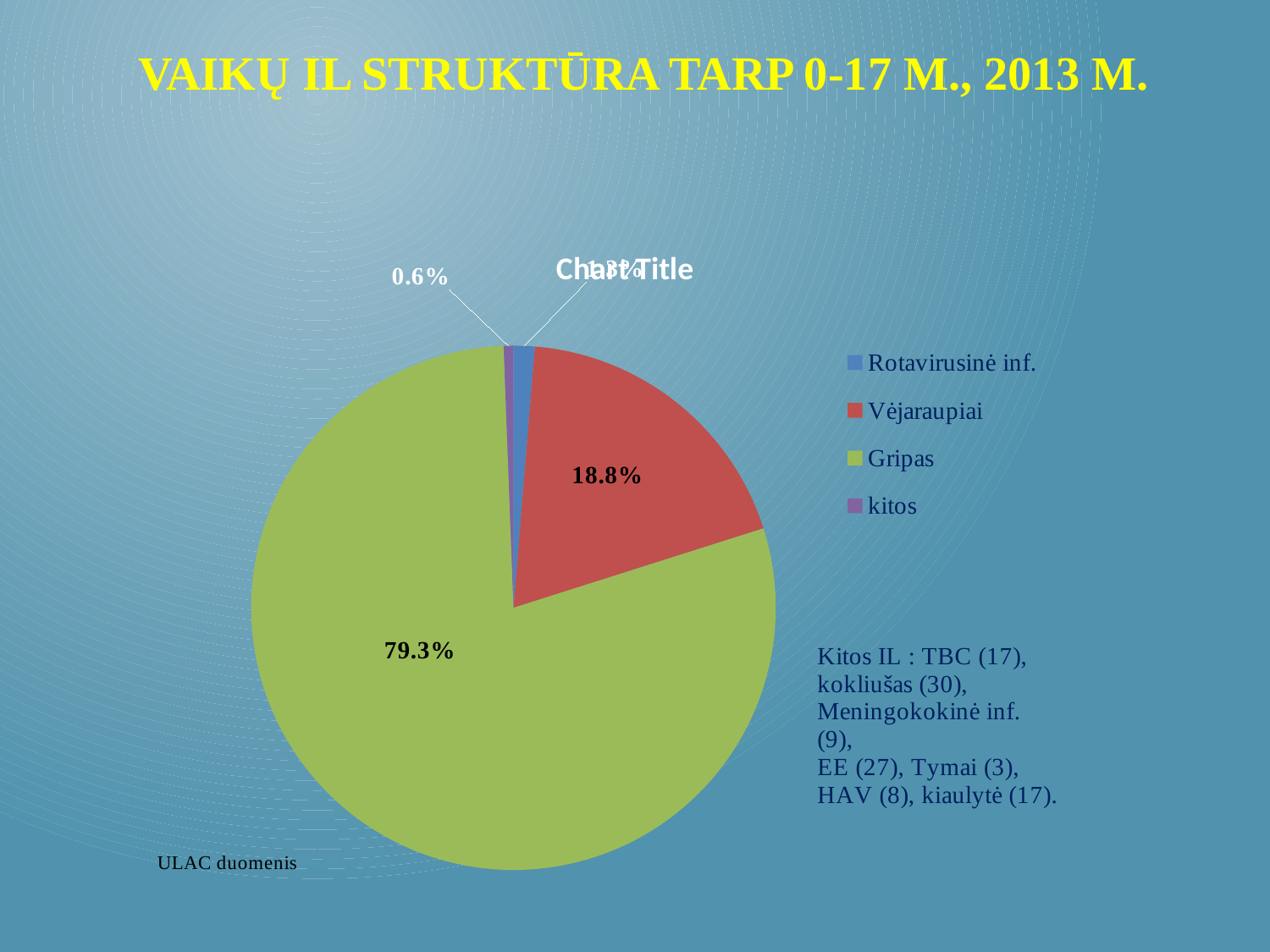
What percentage is shown for Vėjaraupiai? 18.8% What percentage is shown for the kitos slice? 0.6% Which is larger, the share for Vėjaraupiai or the share for kitos? Vėjaraupiai What is the difference in percentage points between Gripas and Vėjaraupiai? 60.5% How many categories does the pie chart show? 4 How many entries does the legend list? 4 What colour is the Gripas slice in the pie chart? Green What is the data source noted at the bottom left of the slide? ULAC duomenis What share of the pie is taken by Gripas? 79.3% What percentage of the pie does Gripas account for? 79.3% What kind of chart is shown on the slide? Pie chart Which category has the largest slice of the pie? Gripas